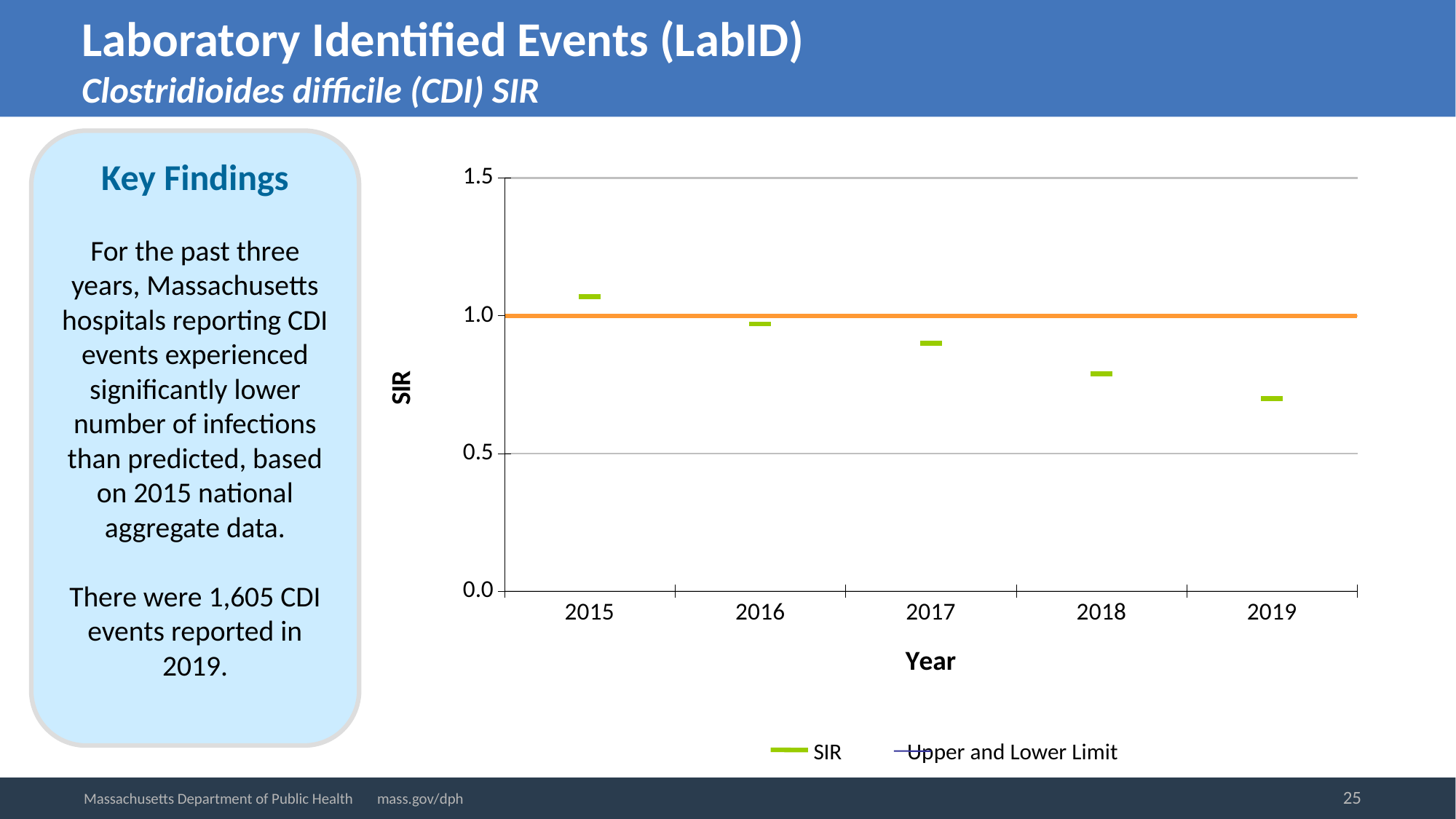
Is the SIR value for 2018 greater or less than 0.5? greater Which year has the larger SIR value, 2017 or 2018? 2017 Do the SIR values rise or fall from 2015 to 2019? fall What are the two entries in the chart legend? SIR; Upper and Lower Limit How many years are shown on the x axis of the chart? 5 What kind of chart is shown on the slide? line chart Which year has the lowest SIR value? 2019 Is the SIR value for 2015 greater or less than 1.0? greater Which year has the highest SIR value? 2015 Is the SIR value for 2019 greater or less than 1.0? less What is the label of the x axis? Year How many series does the chart legend list? 2